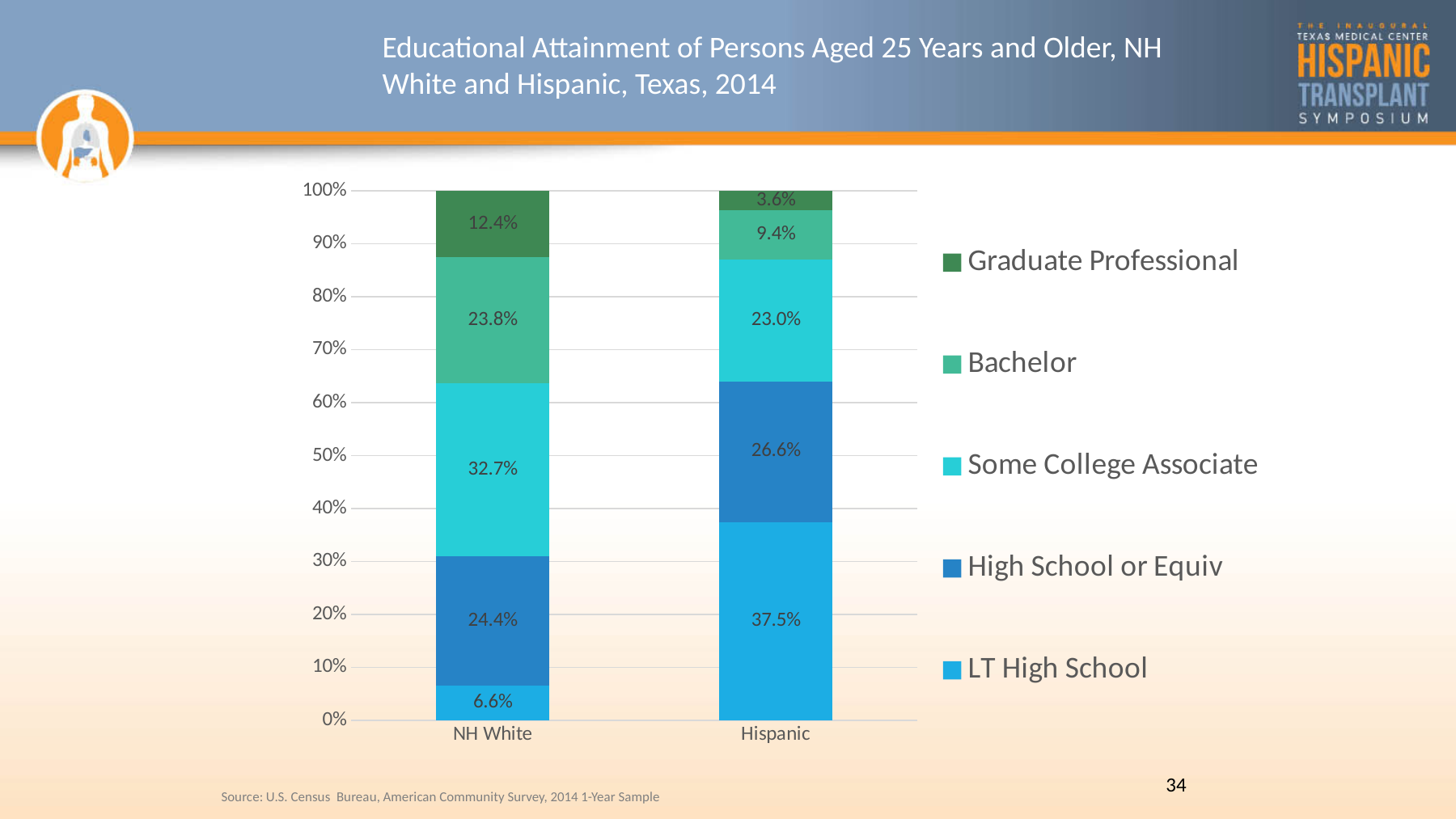
Which group has the larger Graduate Professional share, NH White or Hispanic? NH White Which education level is the smallest segment of the NH White bar? LT High School What percentage of NH White persons have less than a high school education (LT High School)? 6.6% What is the difference in the LT High School share between Hispanic and NH White? 30.9 percentage points How many series does the legend list? 5 What is the Some College Associate value for NH White? 32.7% What is the difference in the Bachelor share between NH White and Hispanic? 14.4 percentage points What type of chart is shown on the slide? Stacked bar chart Which education level is the largest segment of the Hispanic bar? LT High School What is the Graduate Professional share for Hispanic persons? 3.6% What is the High School or Equiv value for Hispanic? 26.6% How many groups (bars) are shown on the x axis? 2